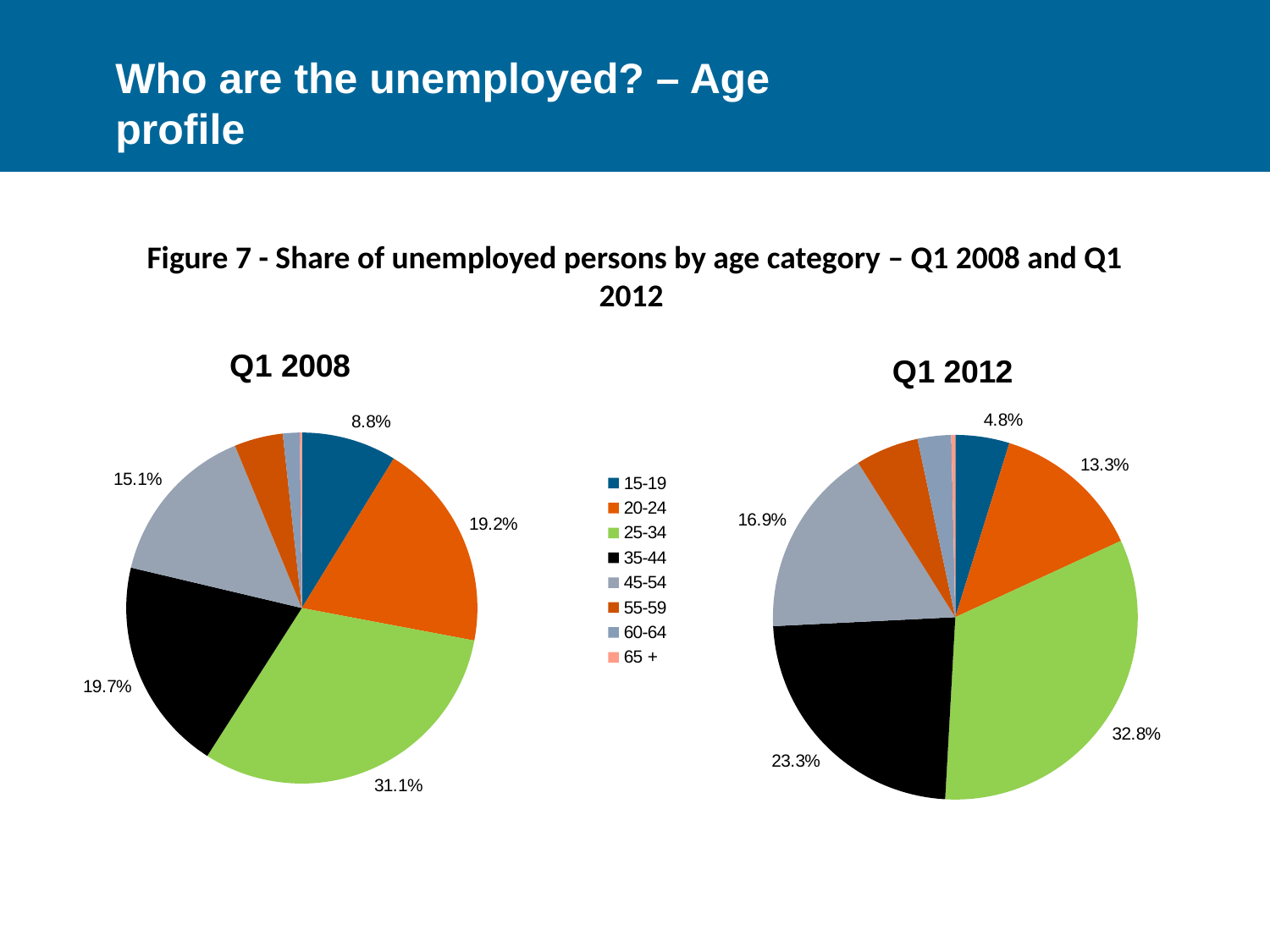
In the Q1 2008 pie chart, what share of unemployed persons is in the 45-54 age category? 15.1% In the Q1 2012 pie chart, what share of unemployed persons is in the 35-44 age category? 23.3% In the Q1 2012 pie chart, which age category has the largest share? 25-34 How many age categories does the legend list? 8 What is the difference between the 20-24 share in the Q1 2008 chart and the 20-24 share in the Q1 2012 chart? 5.9% In the Q1 2008 pie chart, which age category has the largest share? 25-34 In the Q1 2008 pie chart, what share of unemployed persons is in the 25-34 age category? 31.1% In the Q1 2012 pie chart, what share of unemployed persons is in the 15-19 age category? 4.8% What is the difference between the 25-34 share in the Q1 2012 chart and the 25-34 share in the Q1 2008 chart? 1.7% In the Q1 2008 pie chart, which is larger: the share for 20-24 or the share for 15-19? 20-24 What is the title of the figure shown on the slide? Figure 7 - Share of unemployed persons by age category – Q1 2008 and Q1 2012 What type of chart is used to show the Q1 2008 and Q1 2012 data? Pie chart